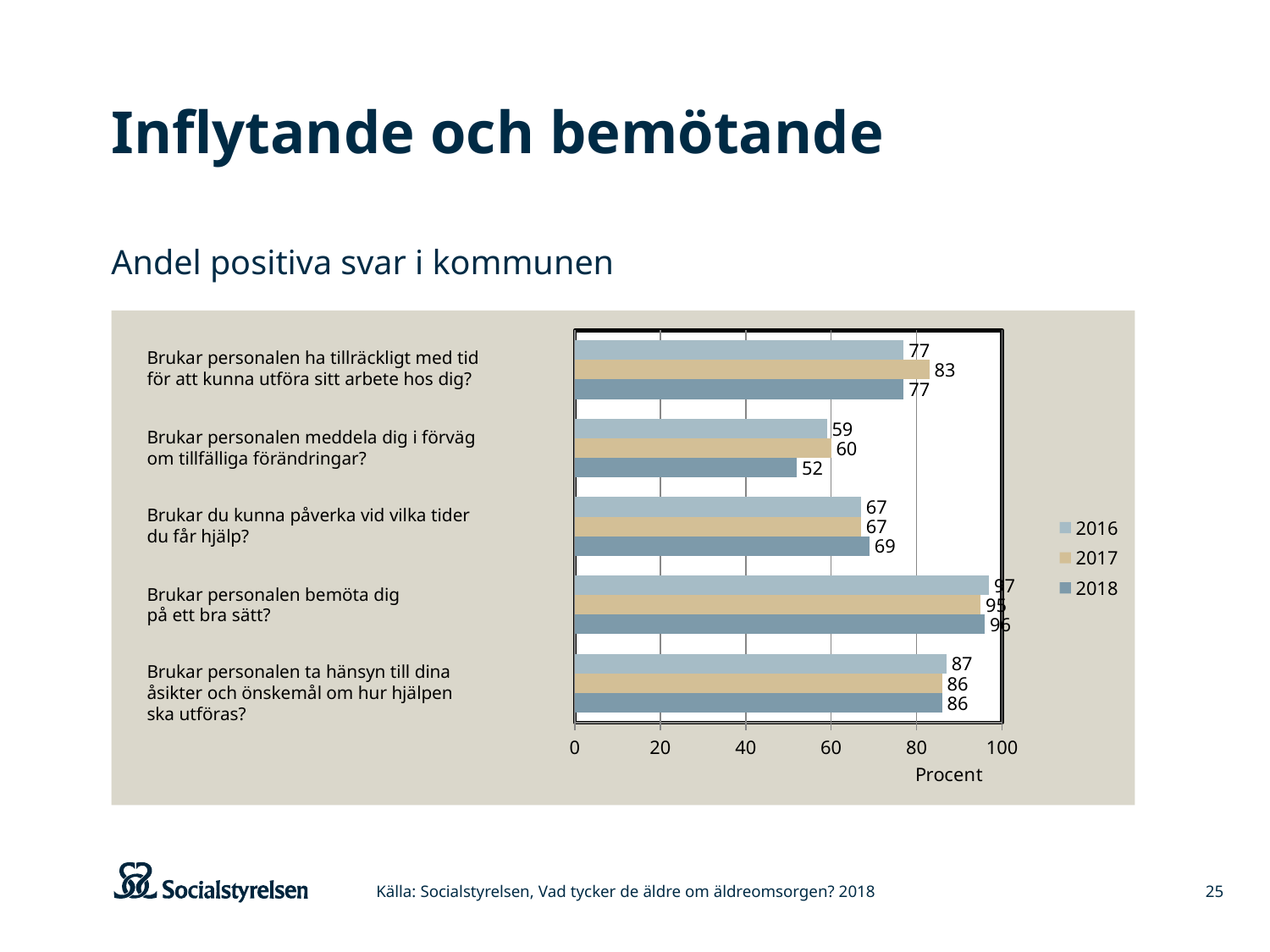
What is the 2017 value for "Brukar personalen ha tillräckligt med tid för att kunna utföra sitt arbete hos dig?"? 83 What kind of chart is shown on the slide? Bar chart What is the difference between the 2017 and 2018 values for "Brukar personalen meddela dig i förväg om tillfälliga förändringar?"? 8 Which is larger for "Brukar personalen ha tillräckligt med tid för att kunna utföra sitt arbete hos dig?": the 2017 value or the 2018 value? 2017 What is the difference between the 2017 and 2016 values for "Brukar personalen ha tillräckligt med tid för att kunna utföra sitt arbete hos dig?"? 6 How many series does the legend list? 3 What is the 2018 value for "Brukar personalen meddela dig i förväg om tillfälliga förändringar?"? 52 Which question has the highest 2016 value? Brukar personalen bemöta dig på ett bra sätt? How many questions (categories) are shown on the chart? 5 What is the 2016 value for "Brukar personalen ta hänsyn till dina åsikter och önskemål om hur hjälpen ska utföras?"? 87 Which question has the lowest 2018 value? Brukar personalen meddela dig i förväg om tillfälliga förändringar? What is the 2018 value for "Brukar du kunna påverka vid vilka tider du får hjälp?"? 69